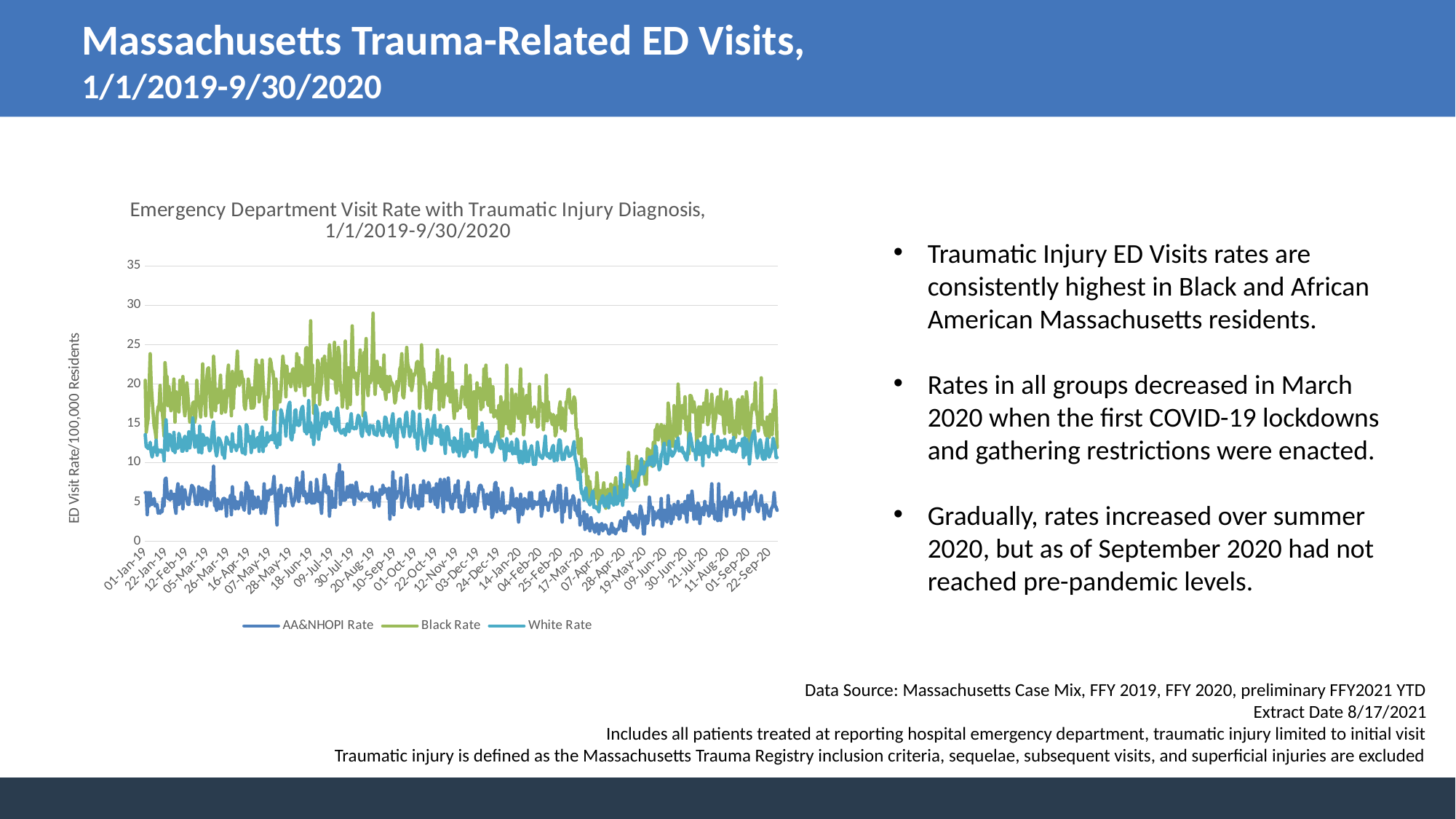
Is the White Rate around 07-Apr-20 greater or less than 10? less What is the highest value shown on the vertical axis of the chart? 35 What is the label on the vertical axis of the chart? ED Visit Rate/100,000 Residents Is the AA&NHOPI Rate around 07-Apr-20 greater or less than 5? less Which series has the highest values across the chart? Black Rate How many series does the chart legend list? 3 Around 01-Jan-19, which is larger, the Black Rate or the White Rate? Black Rate What kind of chart is shown on the slide? line chart Do the rates for all groups rise or fall between 25-Feb-20 and 07-Apr-20? fall Is the Black Rate around 01-Jan-19 greater or less than 15? greater What are the three series named in the chart legend? AA&NHOPI Rate, Black Rate, White Rate Which series has the lowest values across the chart? AA&NHOPI Rate